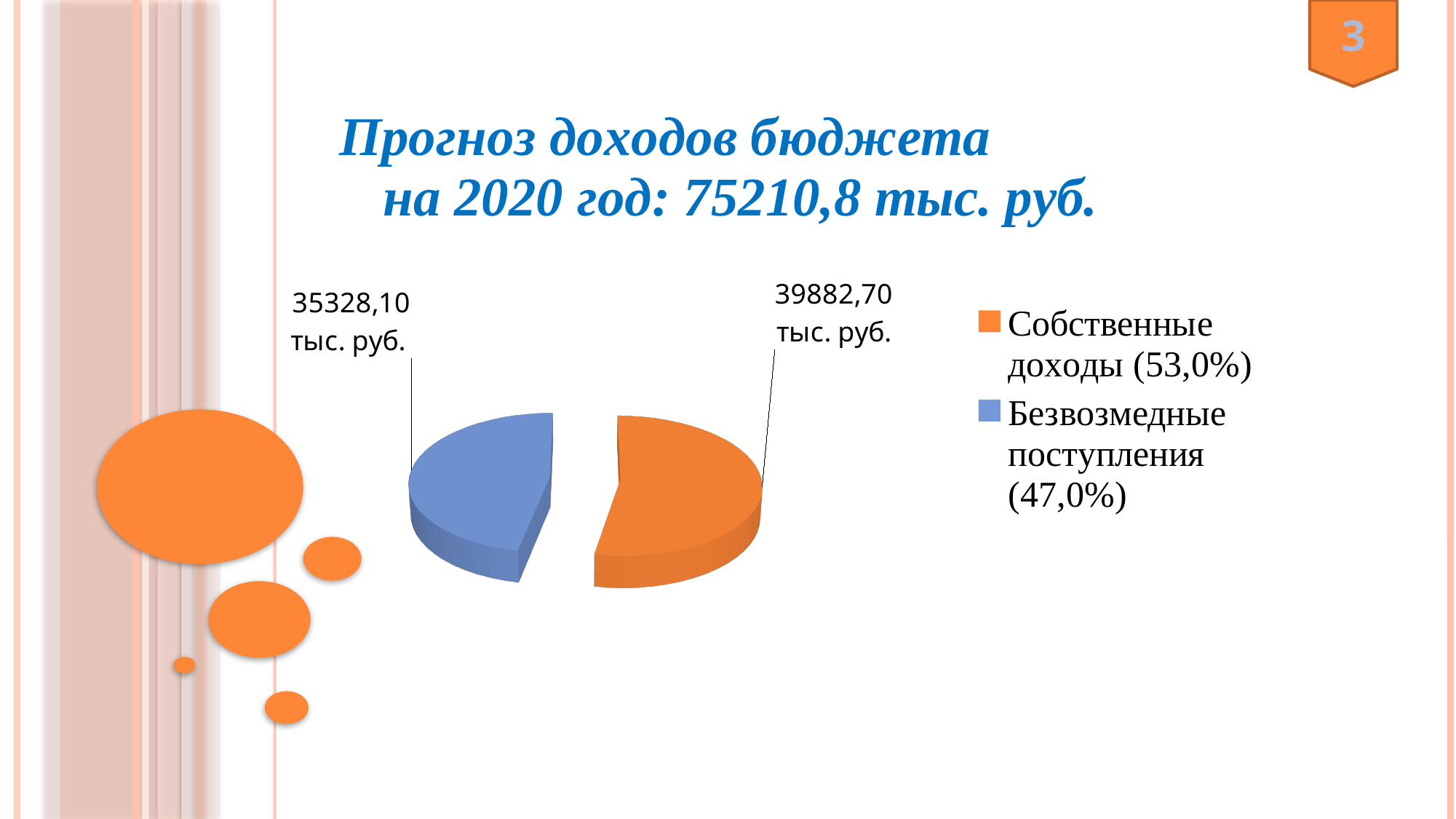
Which category has the smallest slice of the pie? Безвозмедные поступления Which is larger, Собственные доходы or Безвозмедные поступления? Собственные доходы Which category has the largest slice of the pie? Собственные доходы What share of the pie does Безвозмедные поступления represent? 47,0% What kind of chart is shown on the slide? Pie chart What share of the pie does Собственные доходы represent? 53,0% How many entries does the legend list? 2 What is the value for Безвозмедные поступления? 35328,10 тыс. руб. How many slices does the pie chart have? 2 What is the value for Собственные доходы? 39882,70 тыс. руб. What colour is the slice for Безвозмедные поступления? Blue What is the difference between Собственные доходы and Безвозмедные поступления? 4554,60 тыс. руб.